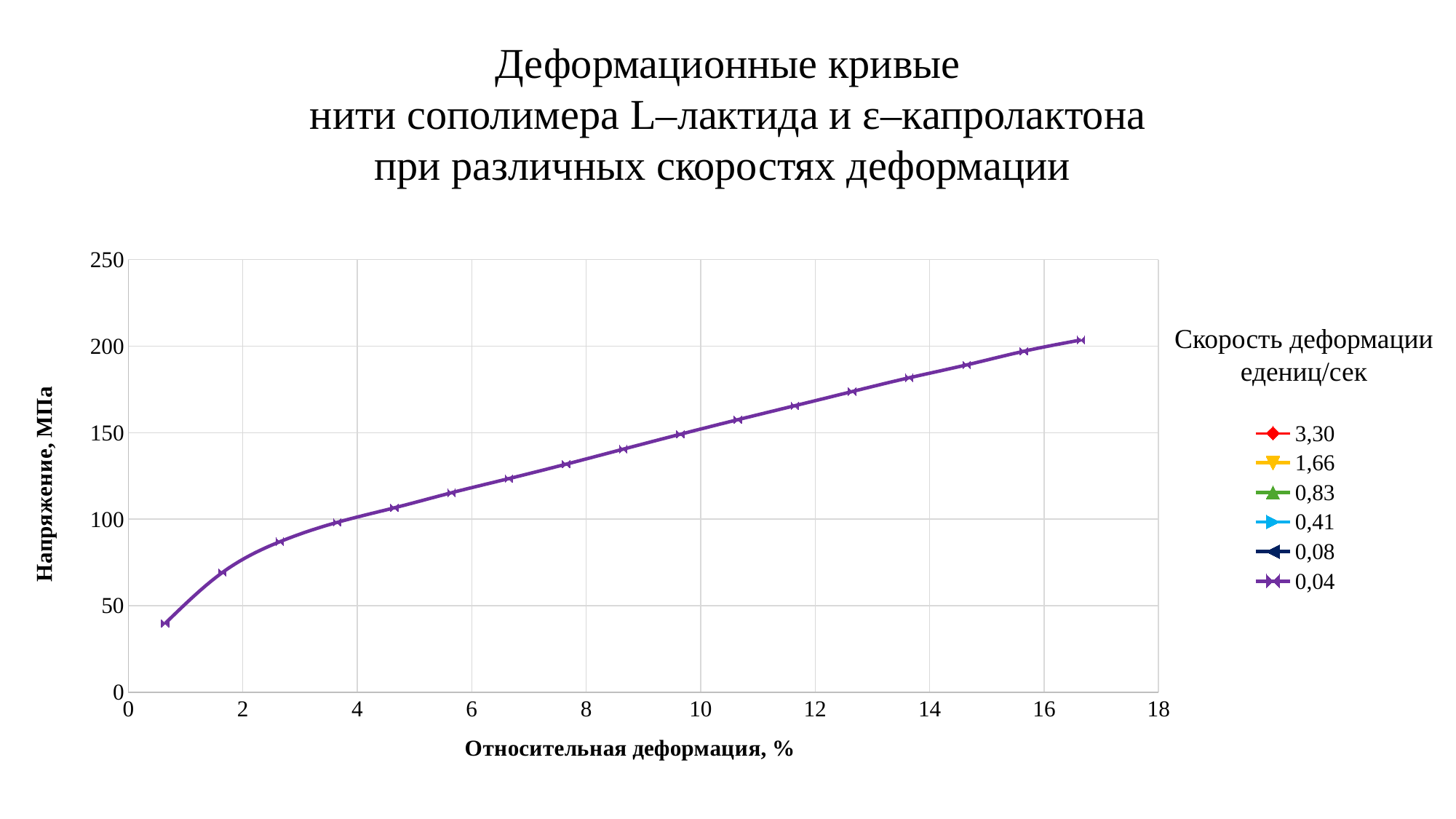
What is the highest value shown on the x axis? 18 Is the stress value at about 8.6% relative deformation greater or less than 100 MPa? greater Is the stress value at about 3.6% relative deformation greater or less than 150 MPa? less What is the highest value shown on the y axis? 250 Is the stress value at the first plotted point (around 0.6% deformation) greater or less than 50 MPa? less How many series does the legend list? 6 What is the title of the y axis? Напряжение, МПа Does the stress (Напряжение) rise or fall as the relative deformation increases along the x axis? rise What kind of chart is shown on the slide? line chart